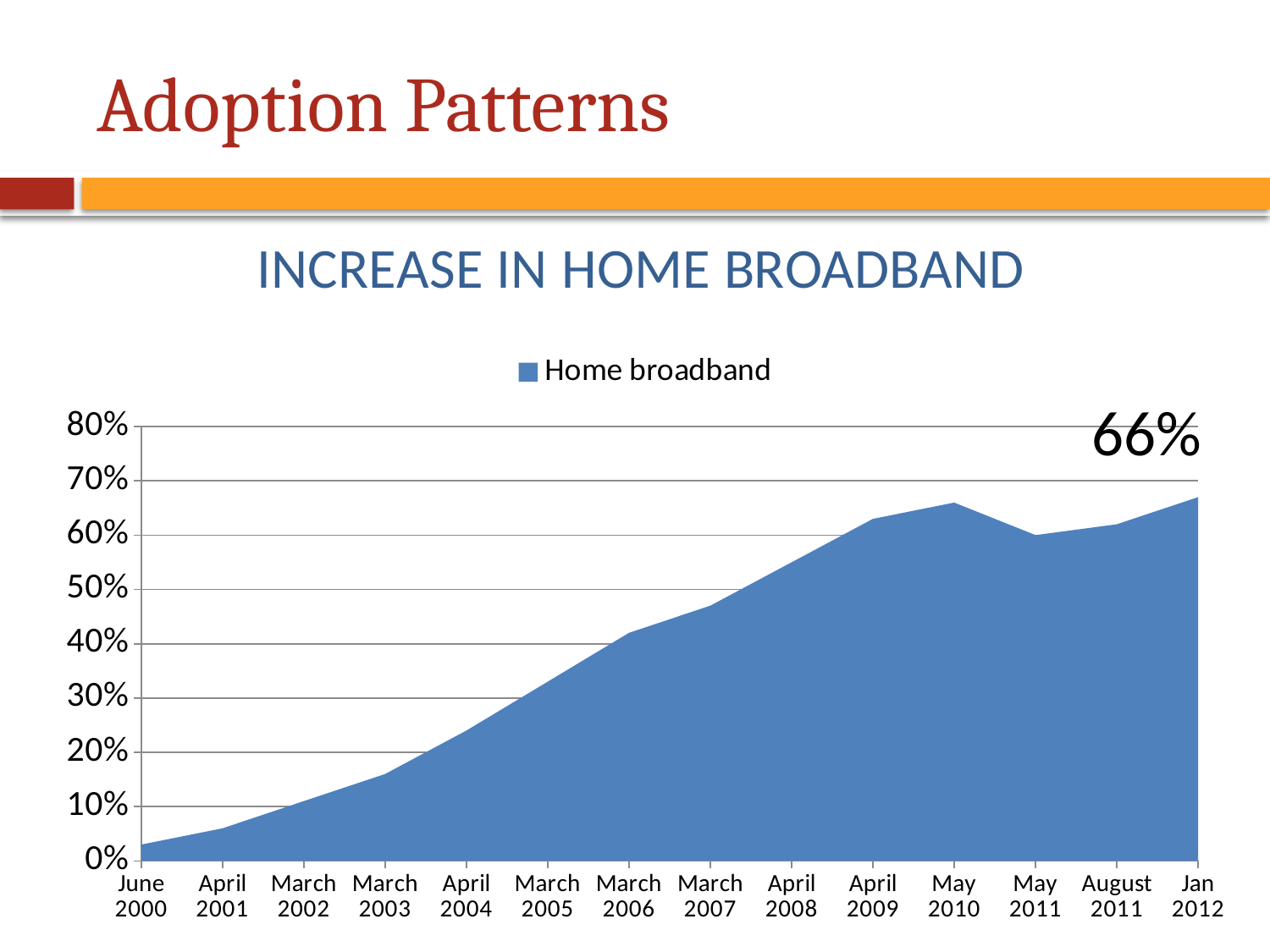
How many time points are plotted along the x axis? 14 What kind of chart is shown on the slide? Area chart What is the title of the chart? INCREASE IN HOME BROADBAND Which time point has the lowest home broadband value? June 2000 Is the value for June 2000 greater or less than 10%? less Do home broadband values generally rise or fall from June 2000 to Jan 2012? Rise How many series does the legend list? 1 Which is larger, the value for March 2005 or the value for April 2009? April 2009 What is the name of the series shown in the legend? Home broadband Is the value for April 2008 greater or less than 50%? greater Is the value for March 2003 greater or less than 20%? less